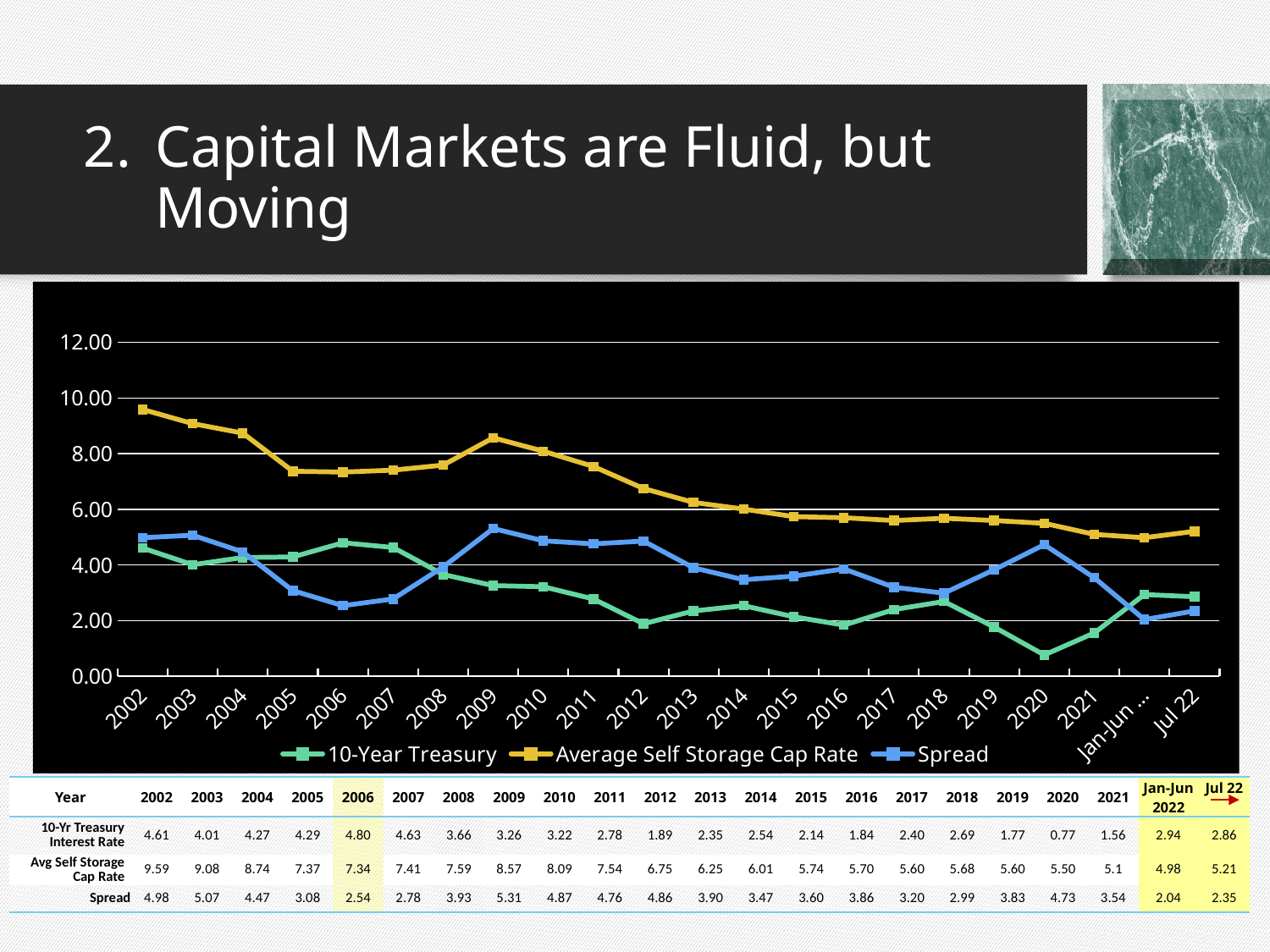
What is the Spread value for Jul 22? 2.35 Does the Average Self Storage Cap Rate generally rise or fall from 2002 to 2021? fall How many time periods are plotted along the x axis of the chart? 22 What is the 10-Year Treasury value for 2020? 0.77 How many series does the chart legend list? 3 What is the difference between the 10-Year Treasury value in 2006 and in 2020? 4.03 In which year is the Average Self Storage Cap Rate highest? 2002 In which period is the 10-Year Treasury value lowest? 2020 Which is larger in 2012, the 10-Year Treasury or the Spread? Spread In which year is the Spread highest? 2009 What kind of chart is shown on the slide? line chart What is the Average Self Storage Cap Rate for 2002? 9.59